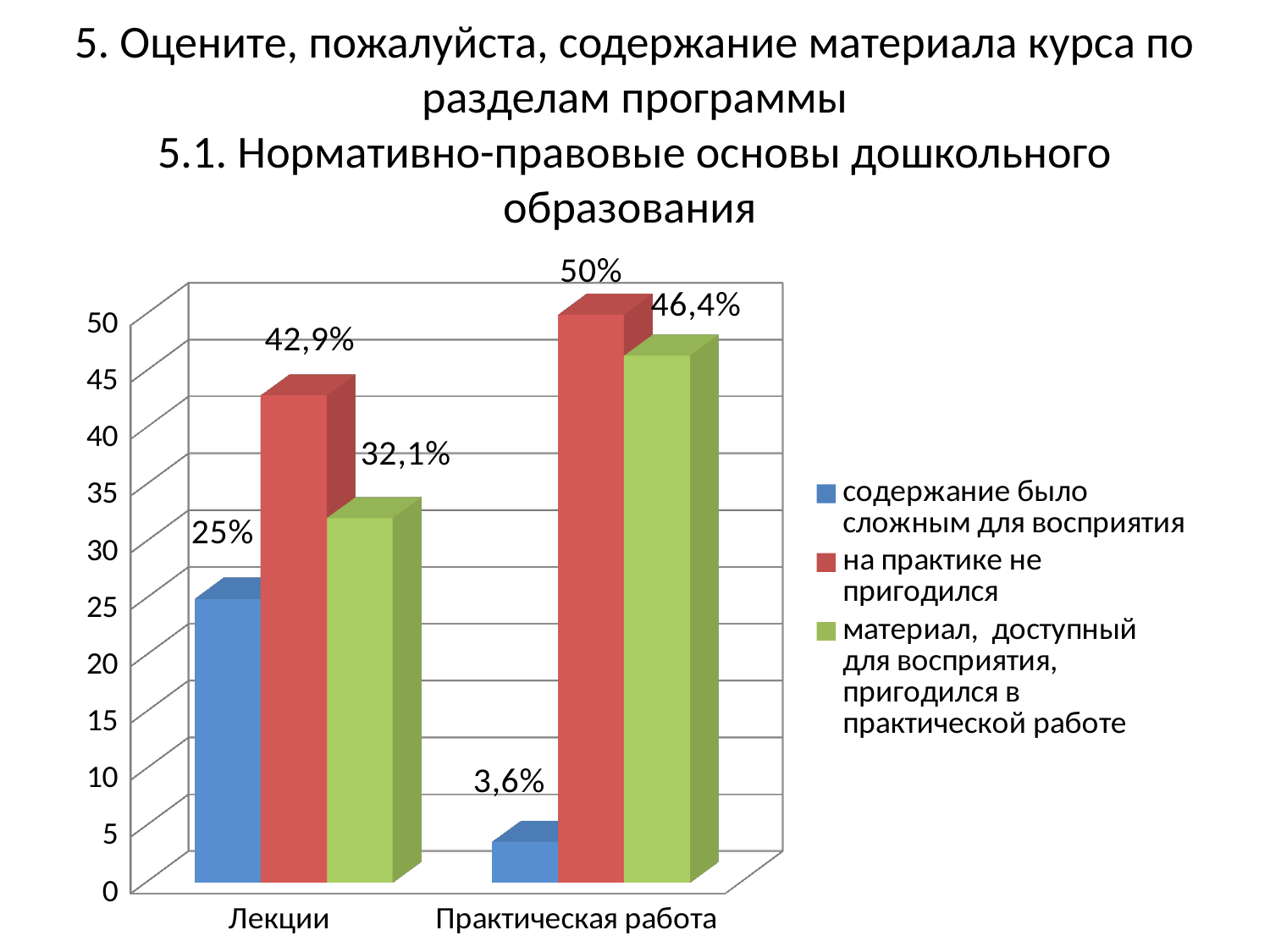
What colour are the bars for the series "на практике не пригодился"? red How many series does the chart's legend list? 3 Which is larger: the "материал, доступный для восприятия, пригодился в практической работе" value for "Лекции" or for "Практическая работа"? Практическая работа What kind of chart is shown on the slide? bar chart What is the difference between the "на практике не пригодился" values for "Практическая работа" and "Лекции"? 7,1% Which series has the lowest value in the "Практическая работа" category? содержание было сложным для восприятия Which series has the highest value in the "Лекции" category? на практике не пригодился What is the value for "содержание было сложным для восприятия" in the "Лекции" category? 25% What is the value for "на практике не пригодился" in the "Практическая работа" category? 50% What is the value for "материал, доступный для восприятия, пригодился в практической работе" in the "Лекции" category? 32,1% How many categories are shown on the x axis of the chart? 2 What is the value for "содержание было сложным для восприятия" in the "Практическая работа" category? 3,6%